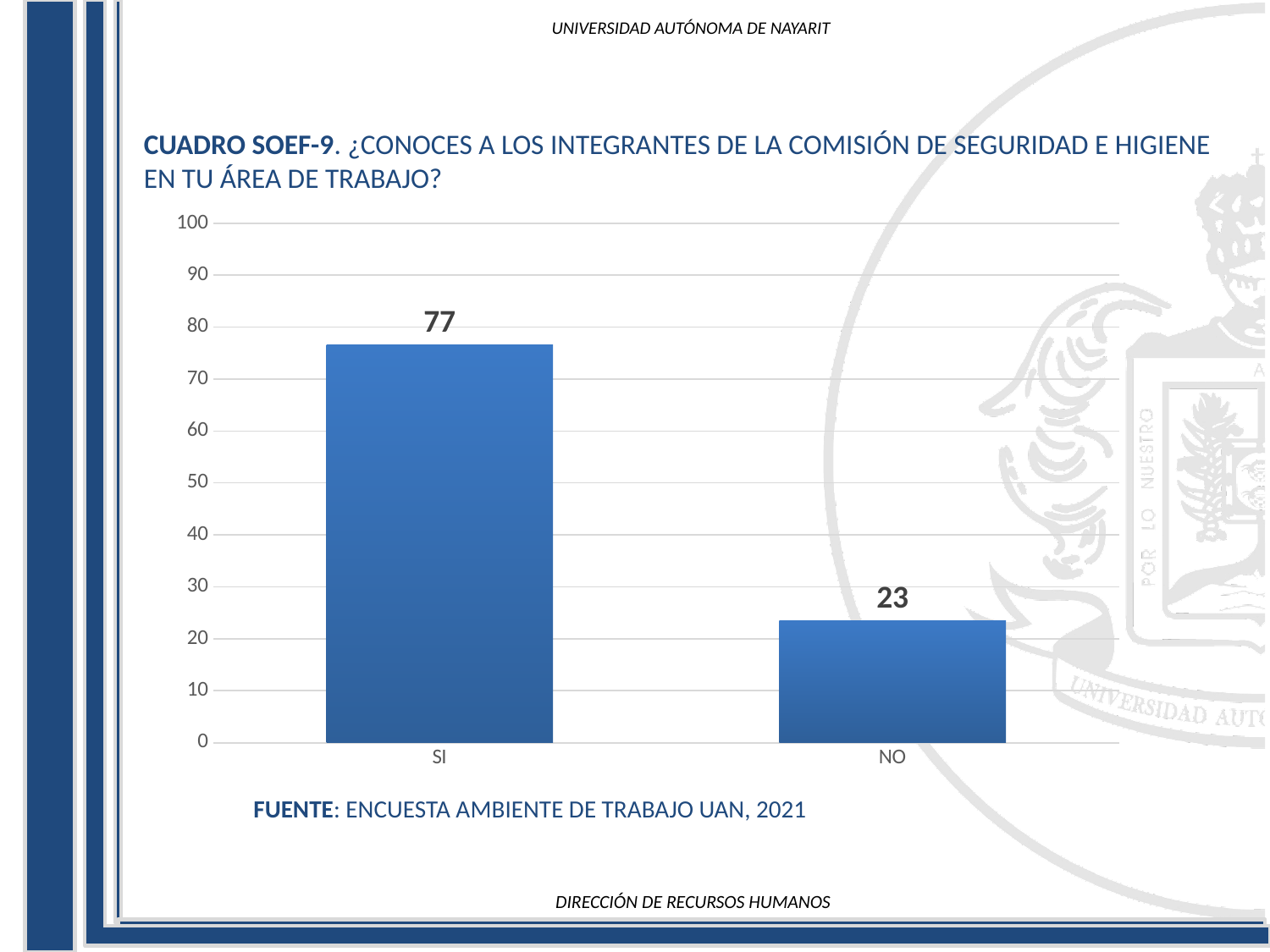
What is the total of the values for SI and NO? 100 What is the value for NO? 23 What is the difference between the values for SI and NO? 54 Which category has the lowest value? NO How many categories are shown on the x axis? 2 What source is cited below the chart? ENCUESTA AMBIENTE DE TRABAJO UAN, 2021 Is the value for SI greater or less than 70? greater Is the value for NO greater or less than 30? less What kind of chart is shown on the slide? bar chart What is the value for SI? 77 Which is larger, the value for SI or the value for NO? SI Which category has the highest value? SI